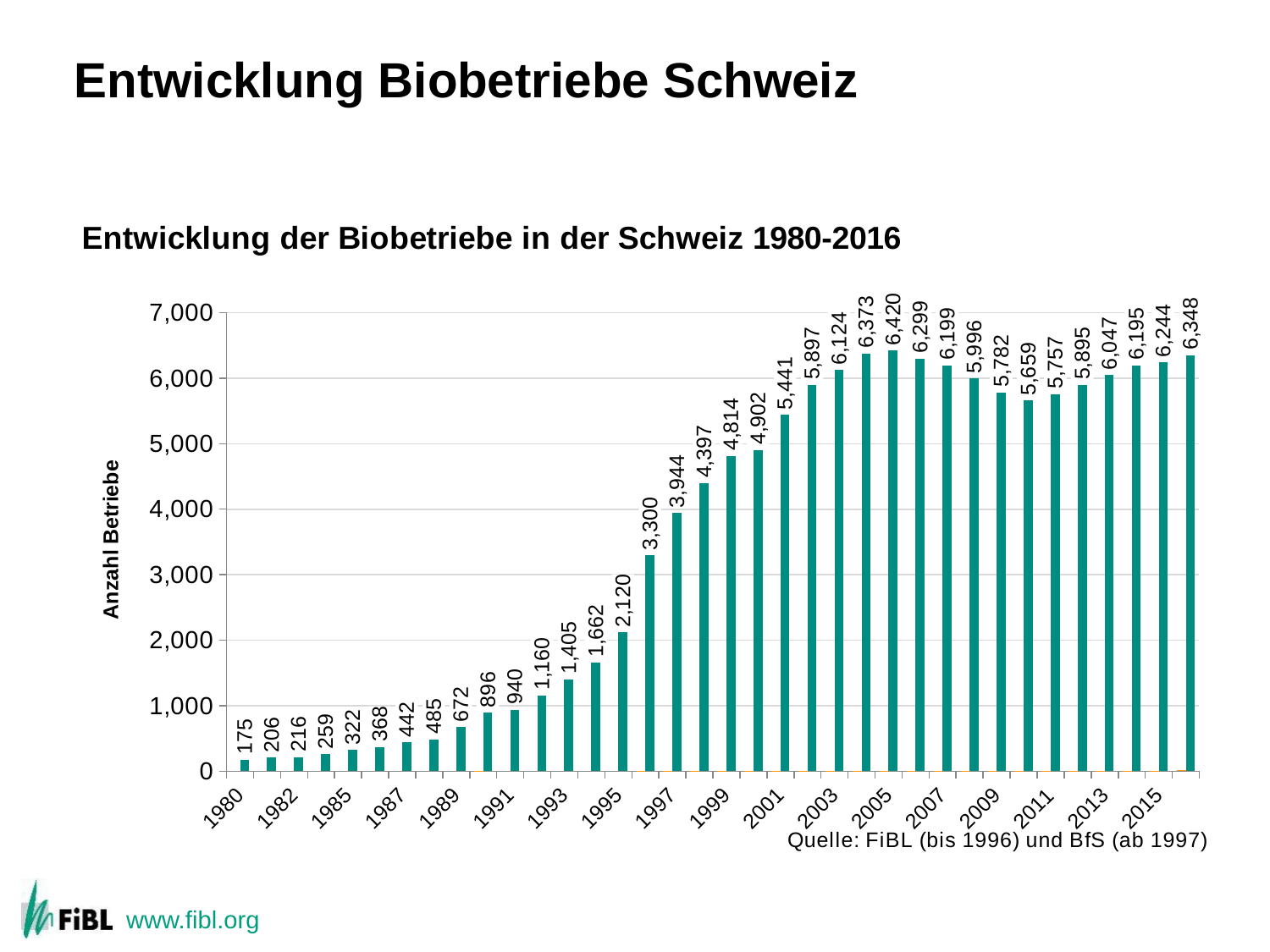
Is the value for 1997 greater or less than 3,000? greater What is the value shown for 1995? 2,120 Which year has a larger value, 2003 or 2009? 2003 What is the value shown for 2005? 6,420 Which year has the lowest number of Biobetriebe? 1980 What is the number of Biobetriebe shown for 1980? 175 What type of chart is shown on the slide? bar chart What is the difference between the values for 2005 and 1980? 6,245 Which year has the highest number of Biobetriebe? 2005 How many bars are plotted in the chart? 36 What is the value shown for 2011? 5,757 What is the title of the vertical axis? Anzahl Betriebe